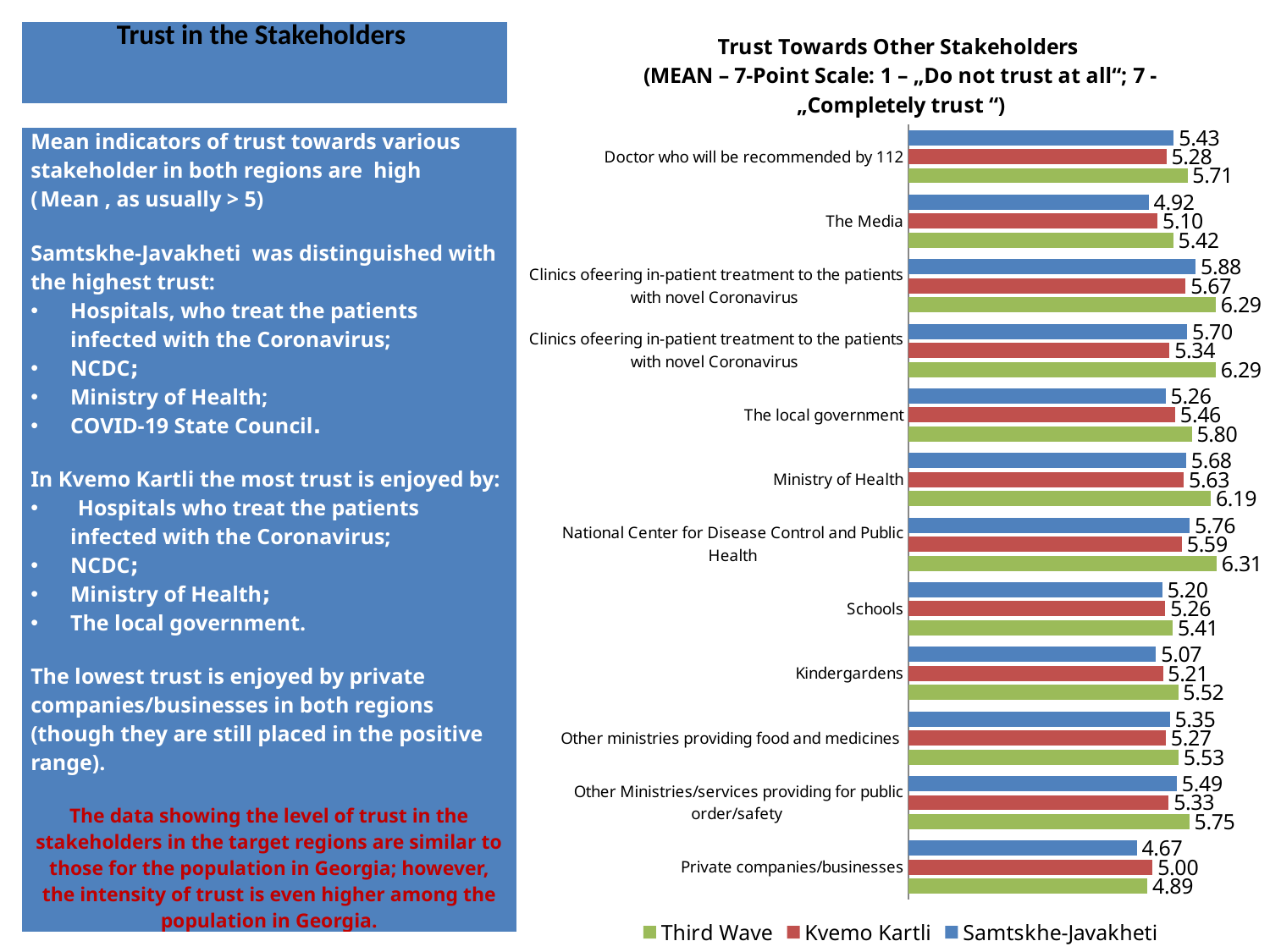
What is the Samtskhe-Javakheti value for The Media? 4.92 Which series is shown in green in the chart? Third Wave Which category has the lowest Samtskhe-Javakheti value? Private companies/businesses Which category has the highest Third Wave value? National Center for Disease Control and Public Health For Schools, which is larger: the Kvemo Kartli value or the Samtskhe-Javakheti value? Kvemo Kartli For Kindergardens, which is larger: the Third Wave value or the Kvemo Kartli value? Third Wave How many series does the chart legend list? 3 What is the difference between the Third Wave and Samtskhe-Javakheti values for Ministry of Health? 0.51 What is the Third Wave value for National Center for Disease Control and Public Health? 6.31 What type of chart is shown on the slide? Bar chart What is the Kvemo Kartli value for The local government? 5.46 What is the Third Wave value for Private companies/businesses? 4.89